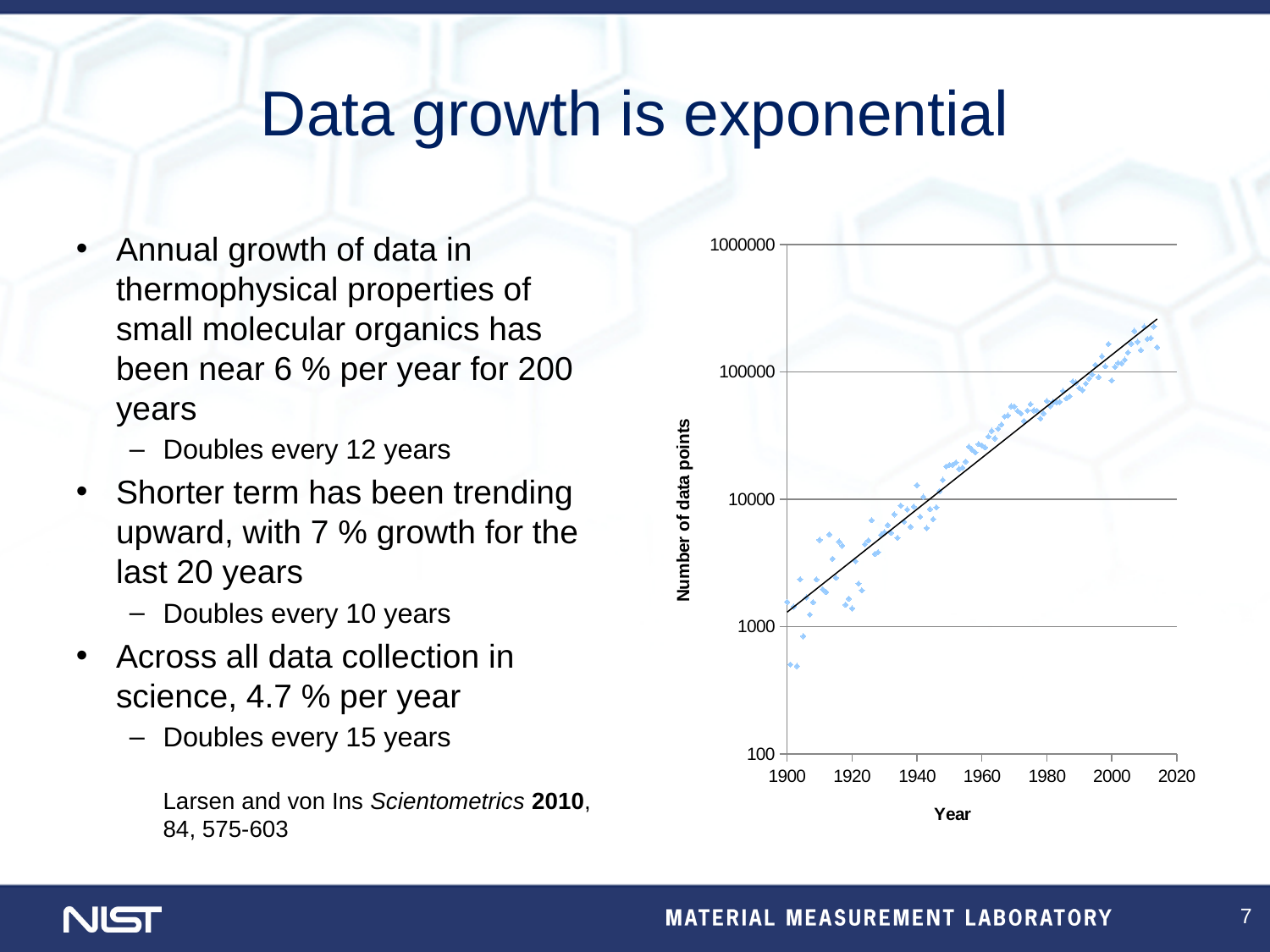
Which year has more data points, 1940 or 2000? 2000 What kind of chart is shown on the slide? scatter chart What is the label of the y axis of the chart? Number of data points What is the highest value shown on the y axis of the chart? 1000000 What is the first year shown on the x axis of the chart? 1900 Is the number of data points around the year 1980 greater or less than 100000? less Is the number of data points around the year 1960 greater or less than 10000? greater Is the number of data points around the year 1920 greater or less than 10000? less Do the plotted values rise or fall as the year increases along the x axis? rise What is the label of the x axis of the chart? Year